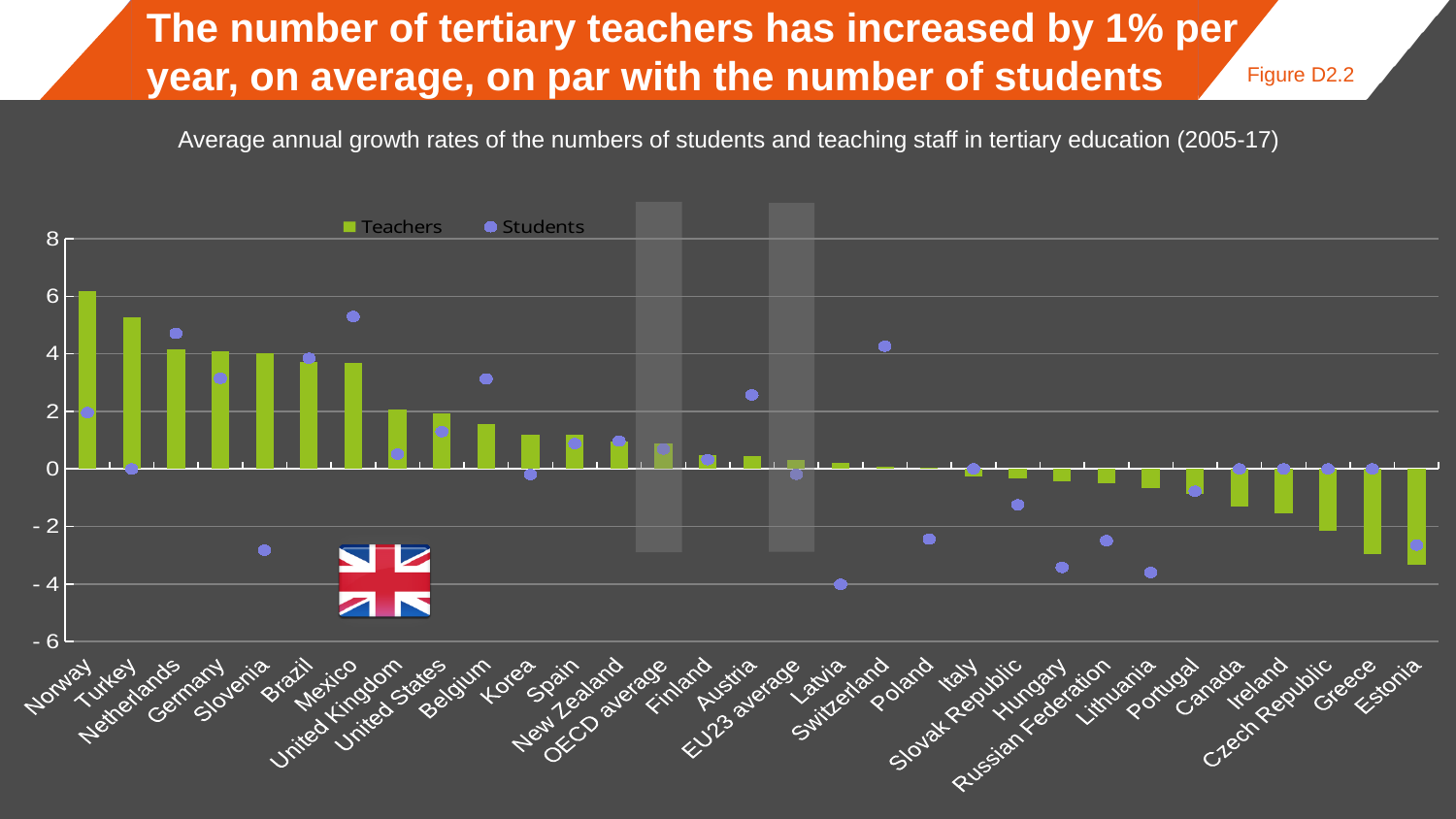
Is the Teachers value for Turkey greater or less than 4? greater How many series does the legend list? 2 Is the Students value for Mexico greater or less than 4? greater Which is larger, the Teachers value for Norway or the Teachers value for Turkey? Norway What kind of chart is shown on the slide? Bar chart (with dot markers for Students) For Mexico, which is larger, the Students value or the Teachers value? Students Is the Students value for Latvia greater or less than -2? less Do the Teachers values rise or fall moving from left to right along the x axis? fall Which country has the highest Teachers value? Norway How many countries or averages are shown along the x axis? 31